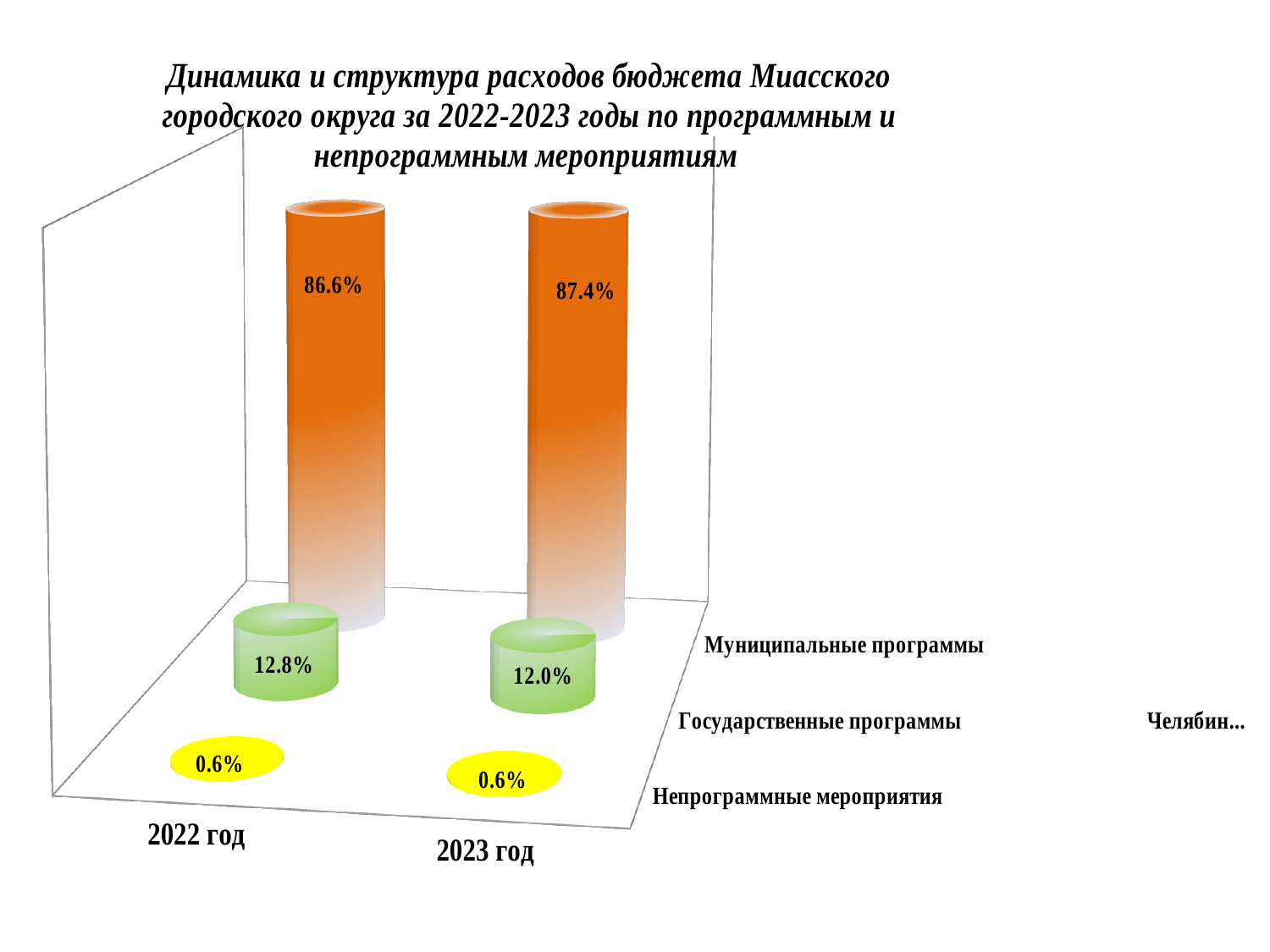
Which is larger: Государственные программы in 2022 год or in 2023 год? 2022 год Which series has the highest value in 2023 год? Муниципальные программы What is the difference between the Муниципальные программы values for 2023 год and 2022 год? 0.8% What is the difference between the Государственные программы values for 2022 год and 2023 год? 0.8% How many years are shown on the x axis? 2 What is the value for Непрограммные мероприятия in 2023 год? 0.6% What is the value for Государственные программы in 2022 год? 12.8% Which series has the lowest value in 2022 год? Непрограммные мероприятия What is the value for Государственные программы in 2023 год? 12.0% What is the value for Муниципальные программы in 2022 год? 86.6% What kind of chart is shown on the slide? Bar chart What is the value for Муниципальные программы in 2023 год? 87.4%